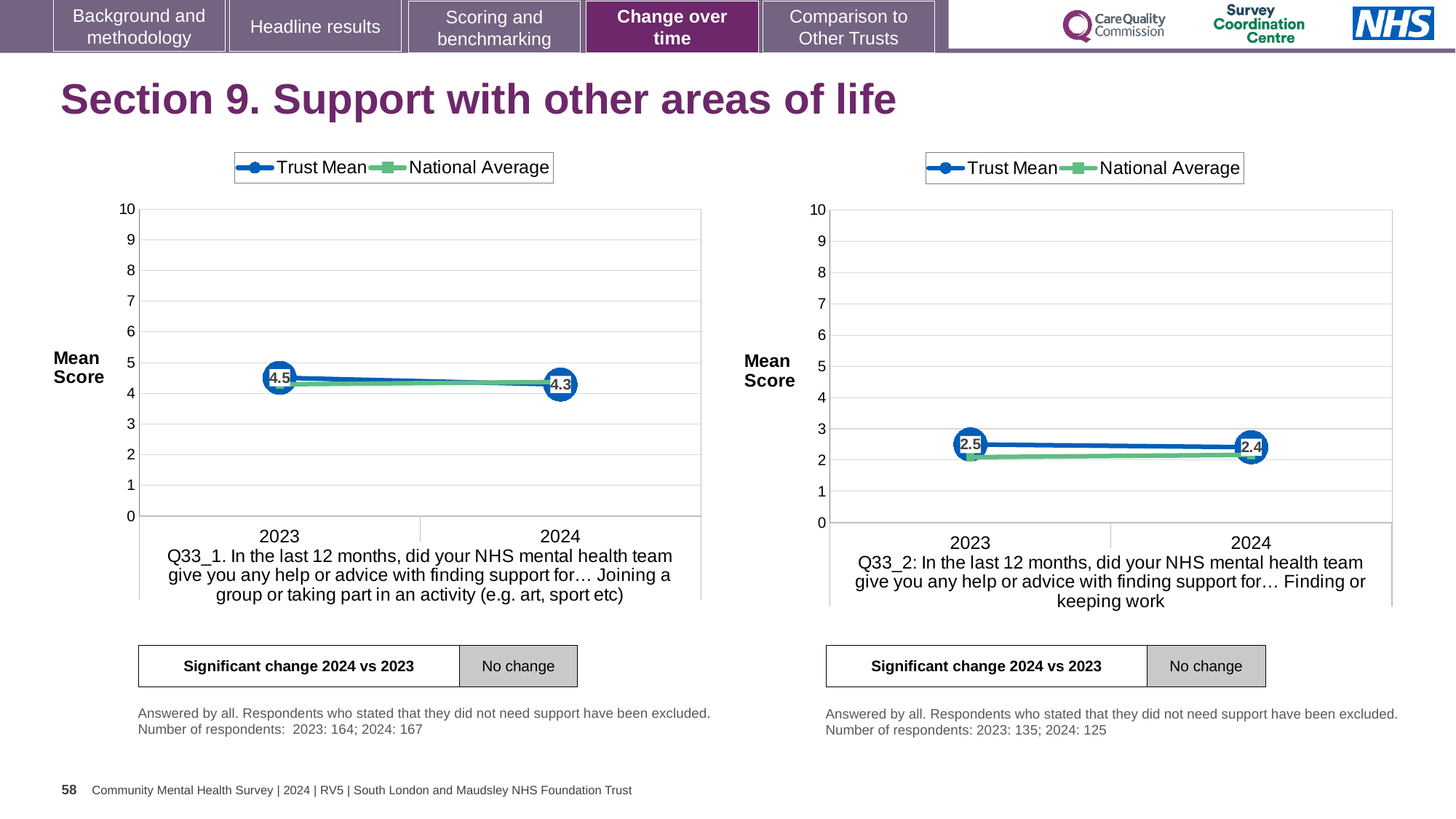
How many years are plotted on the x axis of the right chart (Q33_2)? 2 On the left chart (Q33_1), what is the Trust Mean score for 2024? 4.3 On the left chart (Q33_1), by how much did the Trust Mean change from 2023 to 2024? 0.2 How many series does the legend of the left chart list? 2 On the left chart (Q33_1), what is the Trust Mean score for 2023? 4.5 On the left chart (Q33_1), does the Trust Mean rise or fall from 2023 to 2024? fall On the right chart (Q33_2), what is the Trust Mean score for 2024? 2.4 On the right chart (Q33_2), what is the difference between the Trust Mean in 2023 and 2024? 0.1 On the right chart (Q33_2), which is larger in 2023: the Trust Mean or the National Average? Trust Mean What type of chart is used on the right side of the slide (Q33_2)? line chart On the right chart (Q33_2), is the National Average value for 2023 greater or less than 3? less On the right chart (Q33_2), what is the Trust Mean score for 2023? 2.5